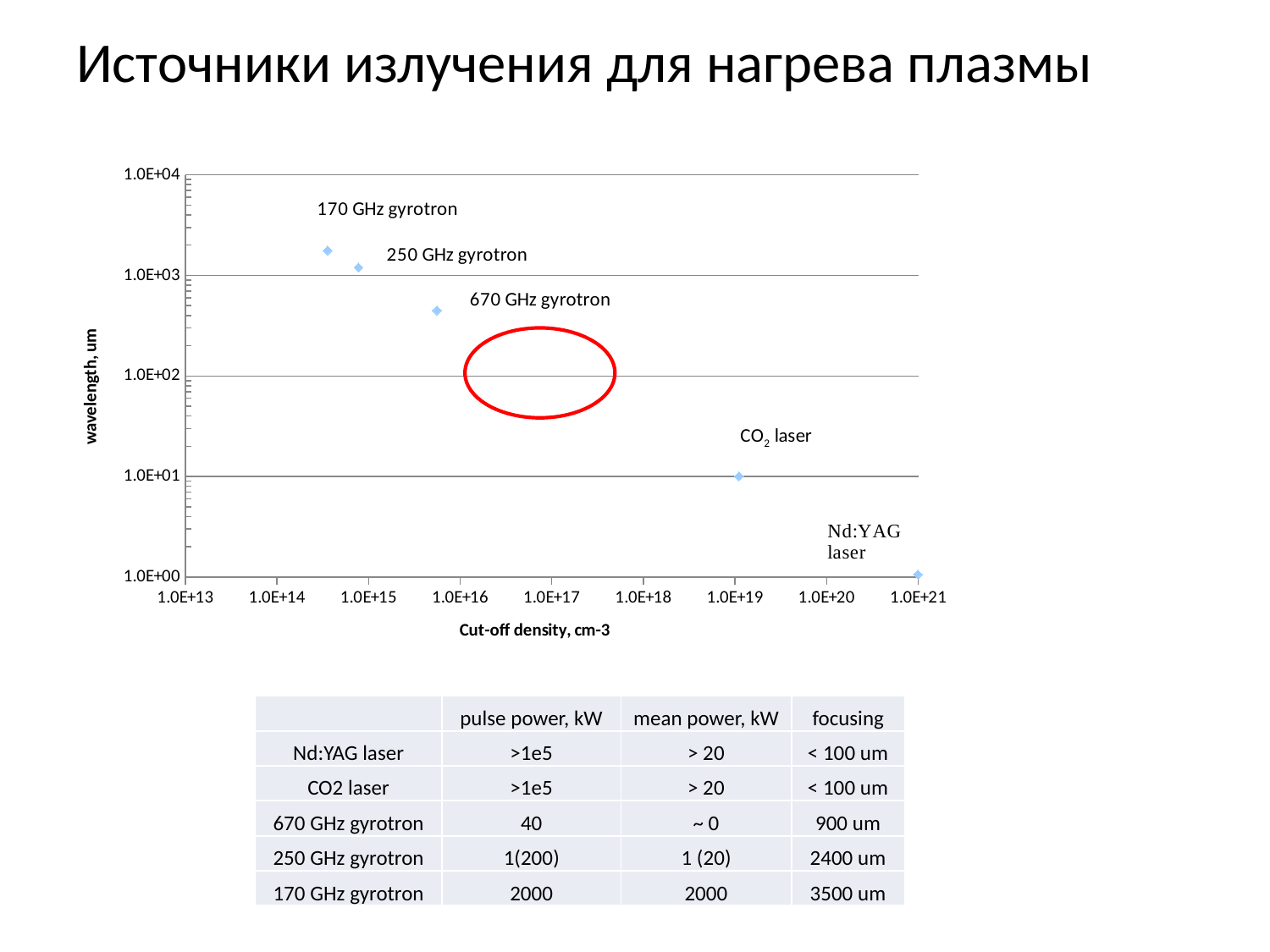
What is the cut-off density of the Nd:YAG laser point on the chart? 1.0E+21 What kind of chart is shown on the slide? scatter chart How many labelled data points are plotted on the chart? 5 As cut-off density increases along the x axis, does the wavelength rise or fall? fall Which has a higher cut-off density, the CO2 laser or the 670 GHz gyrotron? CO2 laser Is the wavelength of the 170 GHz gyrotron greater or less than 1.0E+03? greater Is the wavelength of the 670 GHz gyrotron greater or less than 1.0E+03? less What is the title of the chart's y axis? wavelength, um What is the wavelength of the CO2 laser point on the chart? 1.0E+01 Which radiation source has the lowest wavelength on the chart? Nd:YAG laser Is the cut-off density of the 250 GHz gyrotron greater or less than 1.0E+16? less Which radiation source has the highest wavelength on the chart? 170 GHz gyrotron